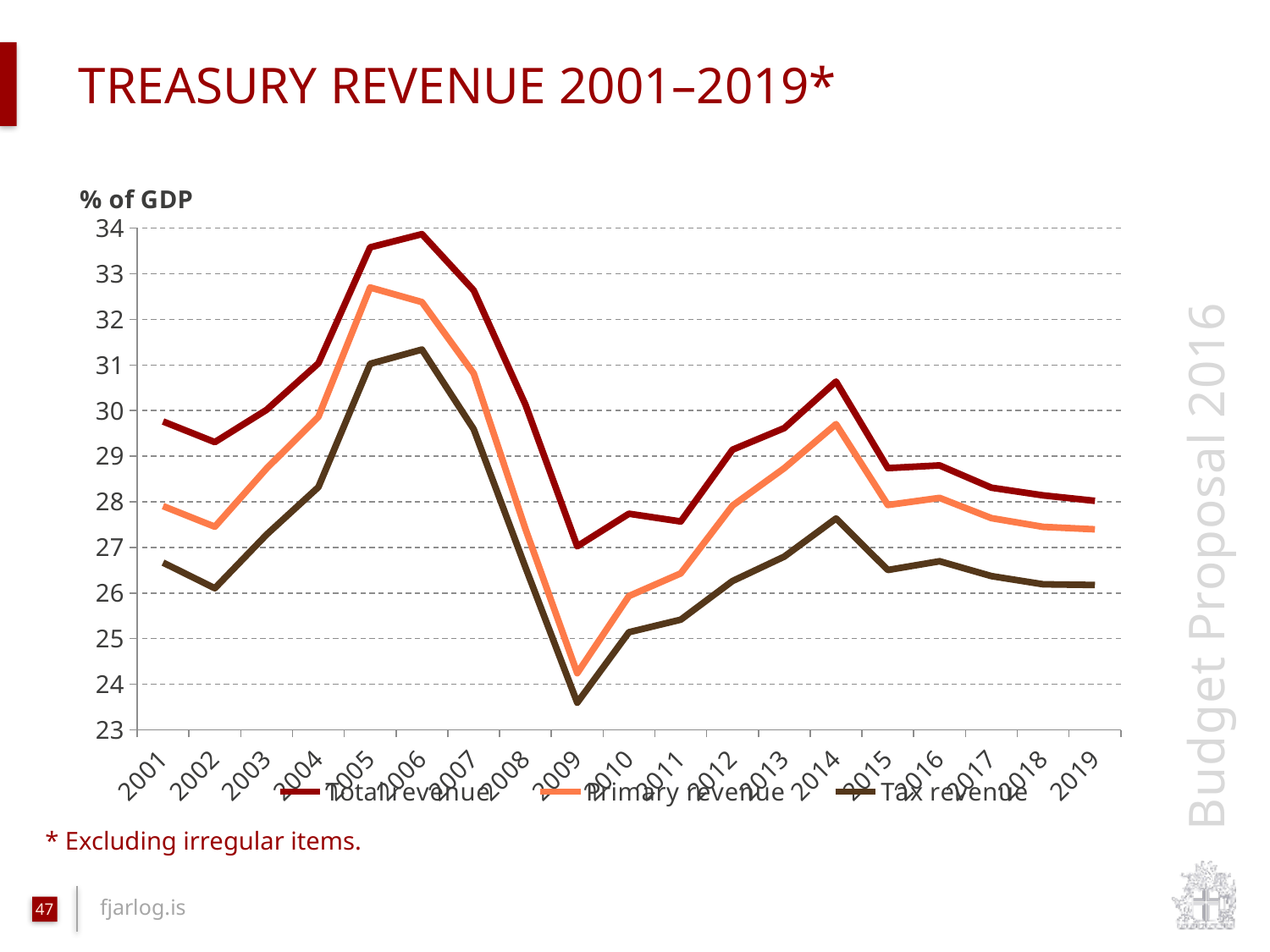
Is the value for Tax revenue in 2009 greater or less than 24? less In which year does Tax revenue reach its lowest value? 2009 Which series has the higher value in 2006, Total revenue or Tax revenue? Total revenue Does Total revenue rise or fall from 2014 to 2019? Fall Is the value for Total revenue in 2006 greater or less than 33? greater What unit is shown on the y axis label? % of GDP Is the value for Primary revenue in 2005 greater or less than 32? greater What kind of chart is shown on the slide? Line chart In which year does Total revenue reach its highest value? 2006 How many years are plotted along the x axis? 19 How many series does the legend list? 3